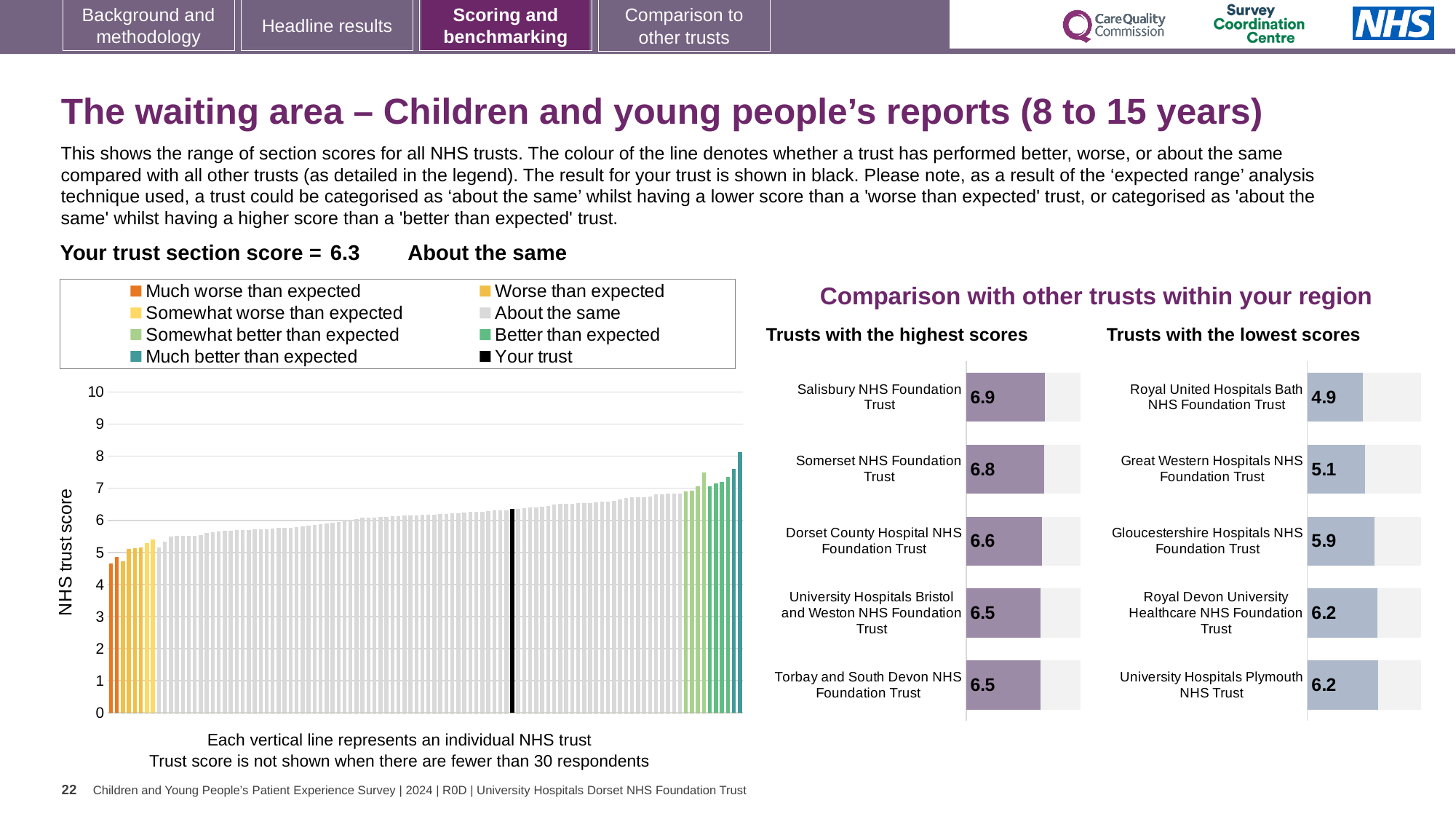
In the 'Trusts with the highest scores' chart, which trust has the highest score? Salisbury NHS Foundation Trust In the 'Trusts with the lowest scores' chart, which has the larger score: Great Western Hospitals NHS Foundation Trust or Gloucestershire Hospitals NHS Foundation Trust? Gloucestershire Hospitals NHS Foundation Trust In the 'Trusts with the highest scores' chart, what is the score for Salisbury NHS Foundation Trust? 6.9 In the 'NHS trust score' chart on the left, is the value of the lowest (leftmost) bar greater or less than 5? less In the 'NHS trust score' chart on the left, what is the section score for your trust (the black bar)? 6.3 In the 'Trusts with the lowest scores' chart, what is the difference between the scores of Gloucestershire Hospitals NHS Foundation Trust and Royal United Hospitals Bath NHS Foundation Trust? 1.0 In the 'Trusts with the lowest scores' chart, what is the score for Great Western Hospitals NHS Foundation Trust? 5.1 In the 'NHS trust score' chart on the left, do the bar values rise or fall from left to right? rise In the 'Trusts with the highest scores' chart, what is the difference between the scores of Salisbury NHS Foundation Trust and Dorset County Hospital NHS Foundation Trust? 0.3 In the 'Trusts with the highest scores' chart, how many trusts are shown? 5 How many entries does the legend above the 'NHS trust score' chart list? 8 In the 'Trusts with the lowest scores' chart, which trust has the lowest score? Royal United Hospitals Bath NHS Foundation Trust